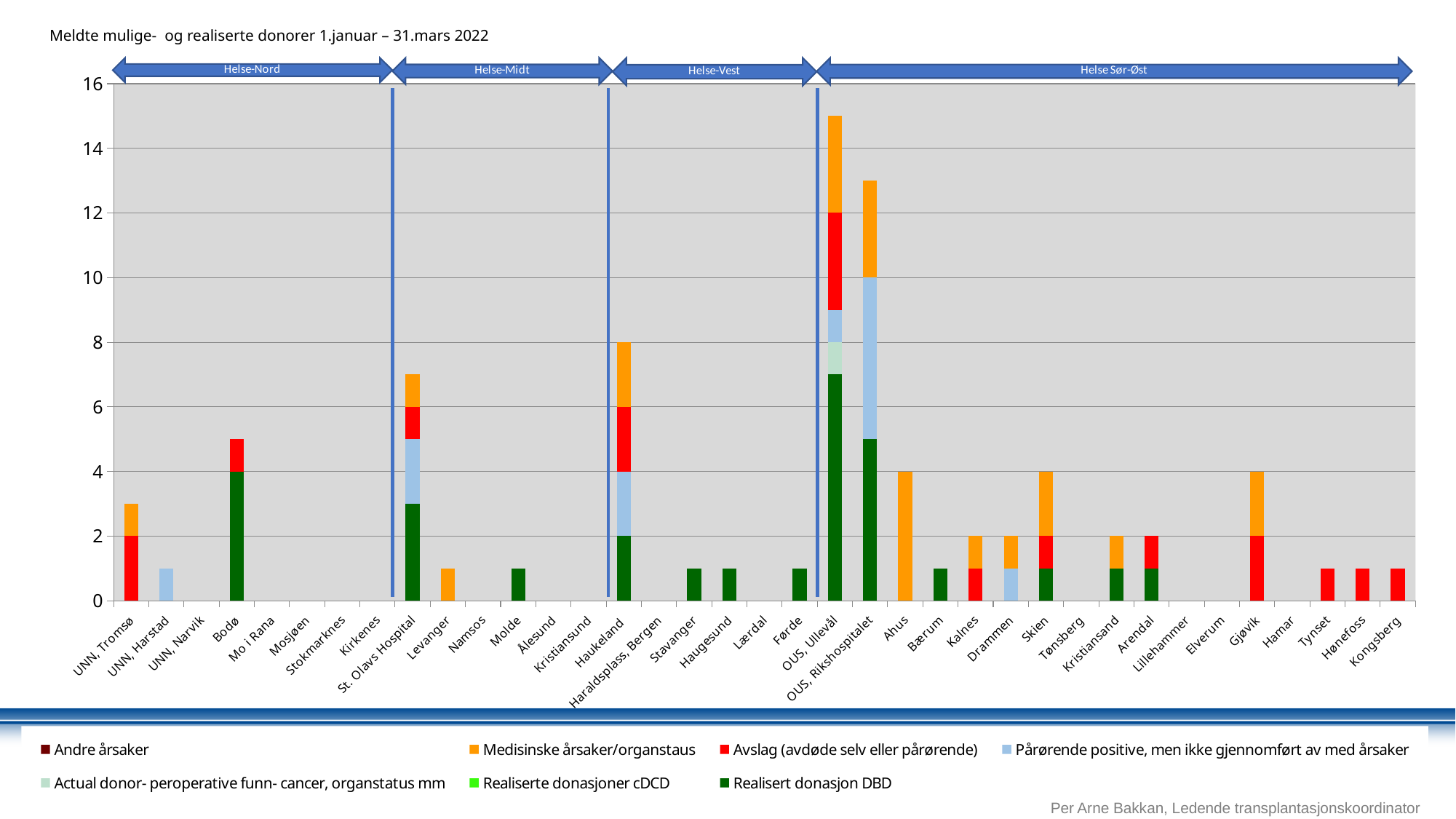
What is the difference between the total for Haukeland and the total for Ahus? 4 Is the total for OUS, Ullevål greater or less than 14? greater What is the value of the Realisert donasjon DBD segment for Bodø? 4 Is the total for St. Olavs Hospital greater or less than 6? greater How many series does the legend list? 7 Which has the larger total bar, OUS, Ullevål or OUS, Rikshospitalet? OUS, Ullevål What kind of chart is shown on the slide? stacked bar chart What is the total height of the bar for Haukeland? 8 What is the total height of the bar for Ahus? 4 What is the title of the chart? Meldte mulige- og realiserte donorer 1.januar – 31.mars 2022 Which hospital has the highest total bar? OUS, Ullevål How many hospitals are listed along the x axis? 37